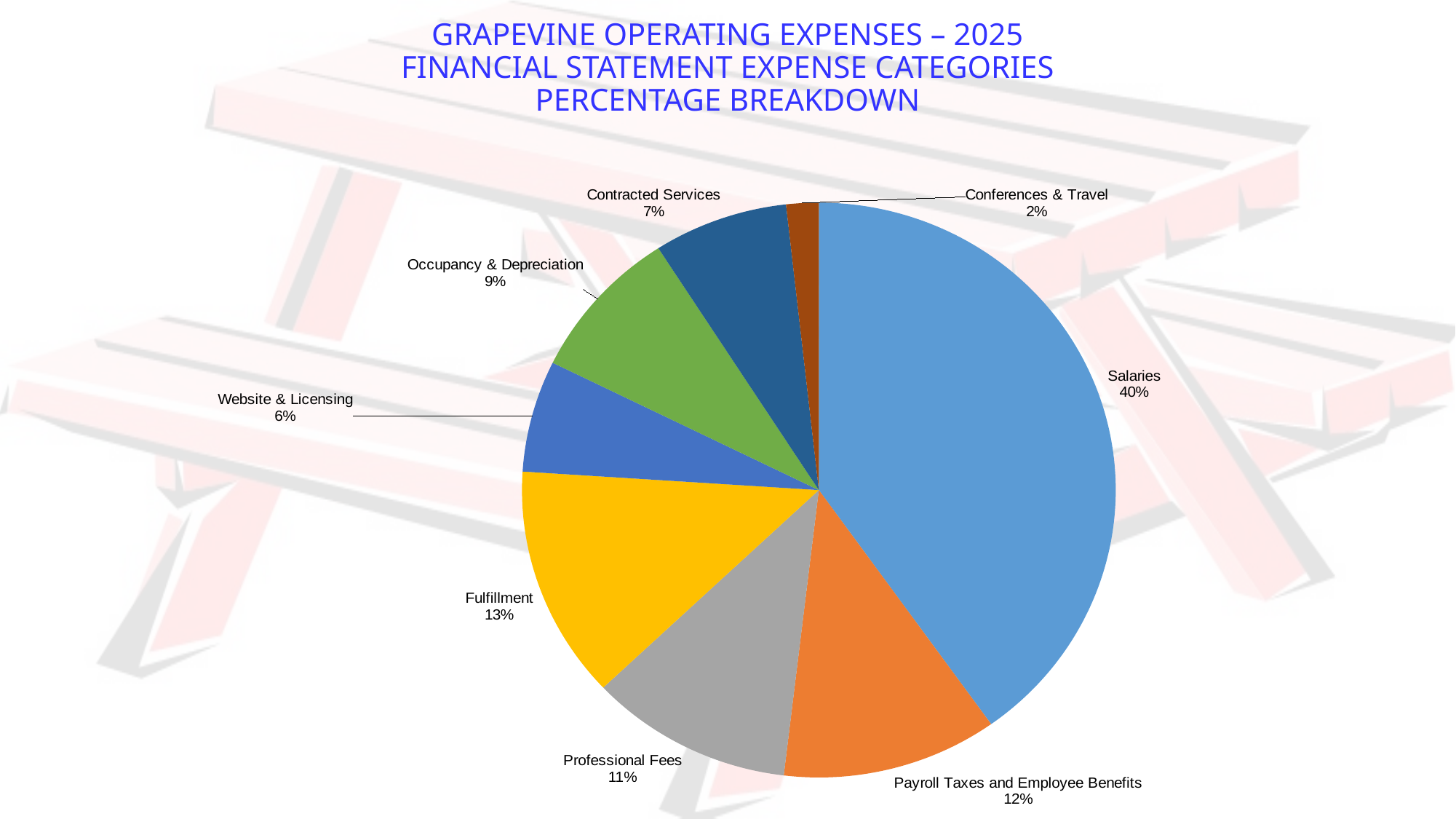
What percentage is shown for Fulfillment? 13% Which expense category has the largest share of the pie? Salaries How many expense categories are shown in the pie chart? 8 What is the difference in percentage points between Salaries and Fulfillment? 27 What colour is the Fulfillment slice? yellow Which expense category has the smallest share of the pie? Conferences & Travel What is the difference in percentage points between Website & Licensing and Conferences & Travel? 4 What percentage is shown for Payroll Taxes and Employee Benefits? 12% What type of chart is shown on the slide? pie chart What percentage of operating expenses is Salaries? 40% What percentage is shown for Occupancy & Depreciation? 9% Which is larger, Professional Fees or Contracted Services? Professional Fees